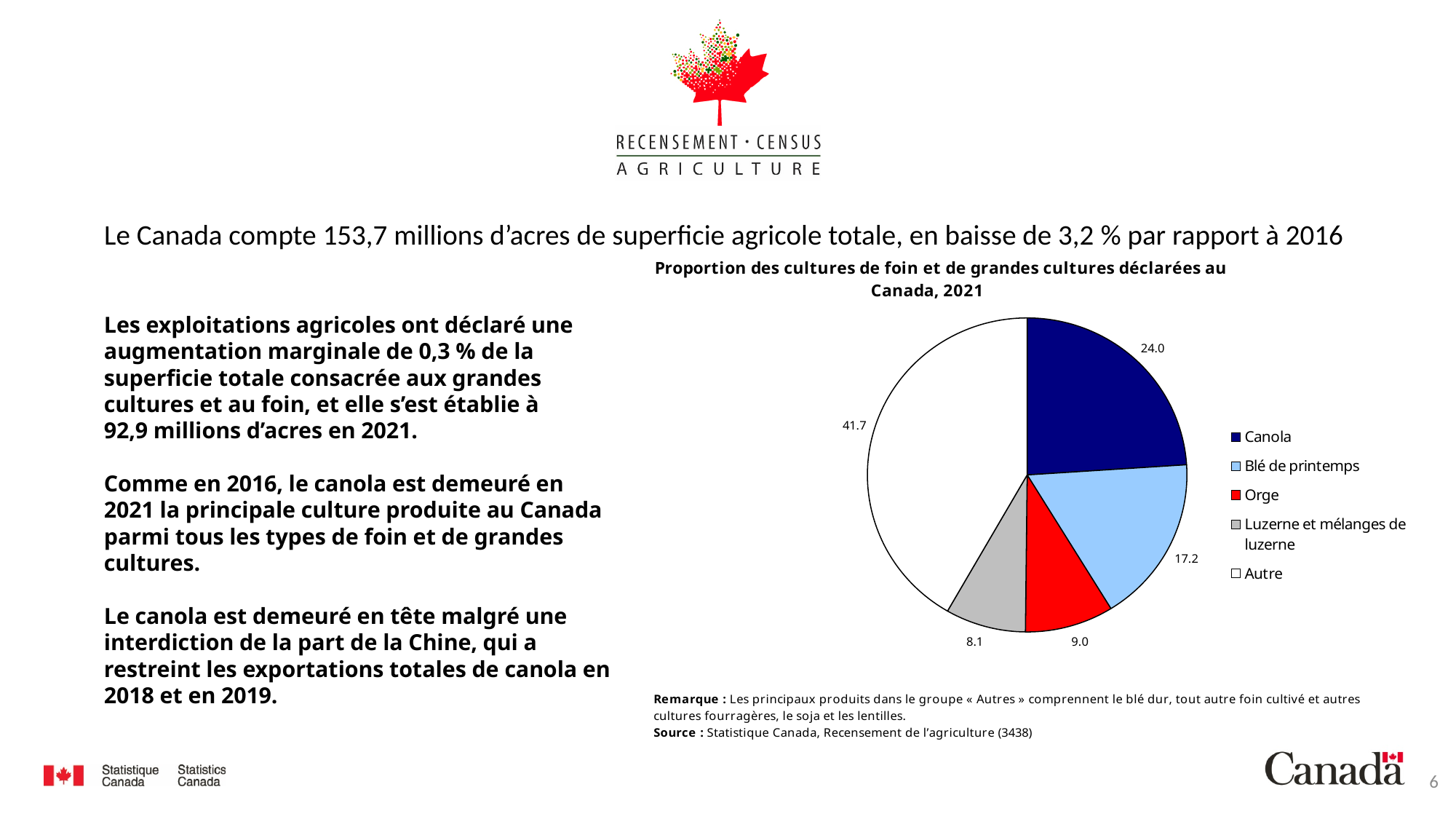
What type of chart is shown on the slide? Pie chart What is the difference between the values for Canola and Blé de printemps? 6.8 What is the value shown for Orge in the pie chart? 9.0 What is the value shown for Autre in the pie chart? 41.7 How many slices does the pie chart have? 5 What is the value shown for Canola in the pie chart? 24.0 What is the value shown for Luzerne et mélanges de luzerne in the pie chart? 8.1 Which is larger in the pie chart, Orge or Luzerne et mélanges de luzerne? Orge Which slice of the pie chart has the smallest value? Luzerne et mélanges de luzerne What is the title of the pie chart? Proportion des cultures de foin et de grandes cultures déclarées au Canada, 2021 What is the value shown for Blé de printemps in the pie chart? 17.2 Which slice of the pie chart has the largest value? Autre